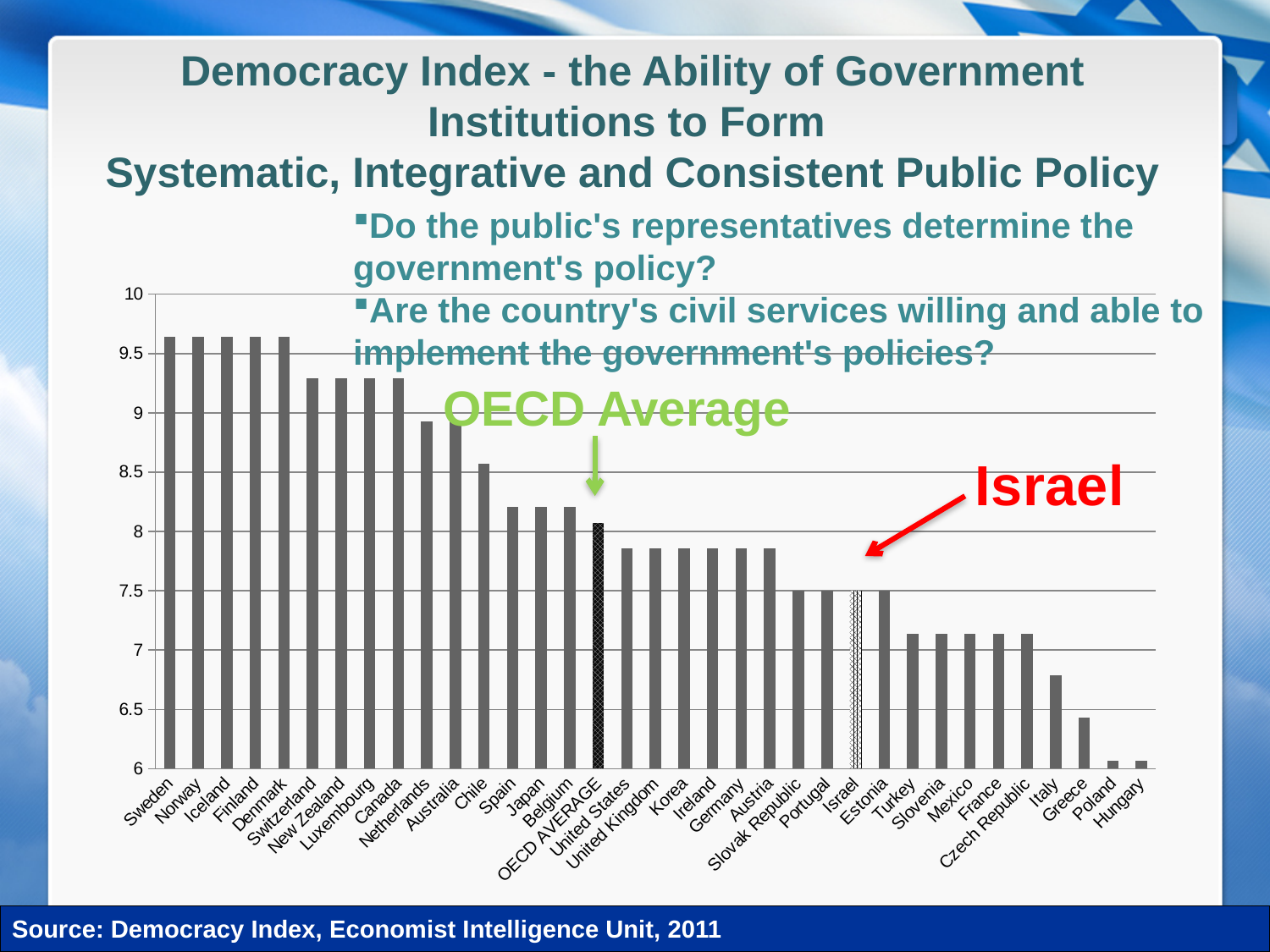
How many countries/categories are plotted along the x axis of the chart? 35 Is the value for Sweden greater or less than 9.5? greater Is the value for Israel greater or less than 8? less Is the value for Italy greater or less than 7? less According to the footer, what is the source of the chart data? Democracy Index, Economist Intelligence Unit, 2011 Which has the larger value, Germany or Israel? Germany What kind of chart is shown on the slide? bar chart Do the values rise or fall moving from left to right along the x axis? fall